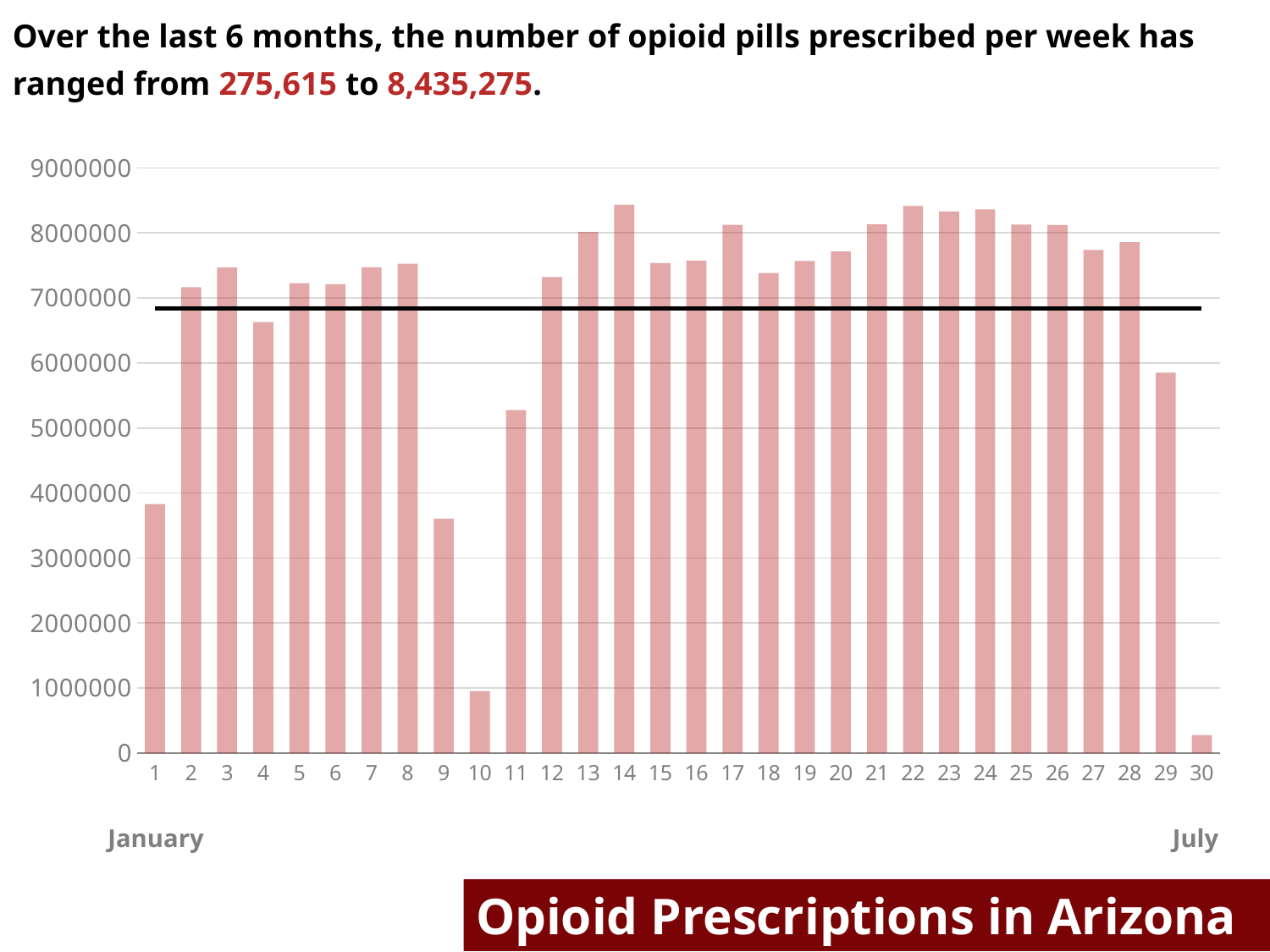
Is the value for week 4 greater or less than 7000000? less What kind of chart is shown on the slide? bar chart Which week has the highest number of opioid pills prescribed? 14 How many weekly bars are plotted on the chart? 30 Is the value for week 10 greater or less than 1000000? less Is the value for week 22 greater or less than 8000000? greater According to the slide text, what is the lowest weekly number of opioid pills prescribed over the last 6 months? 275,615 Which week has a larger value, week 9 or week 11? 11 What is the title shown in the red banner at the bottom of the slide? Opioid Prescriptions in Arizona Which week has the lowest number of opioid pills prescribed? 30 According to the slide text, what is the highest weekly number of opioid pills prescribed over the last 6 months? 8,435,275